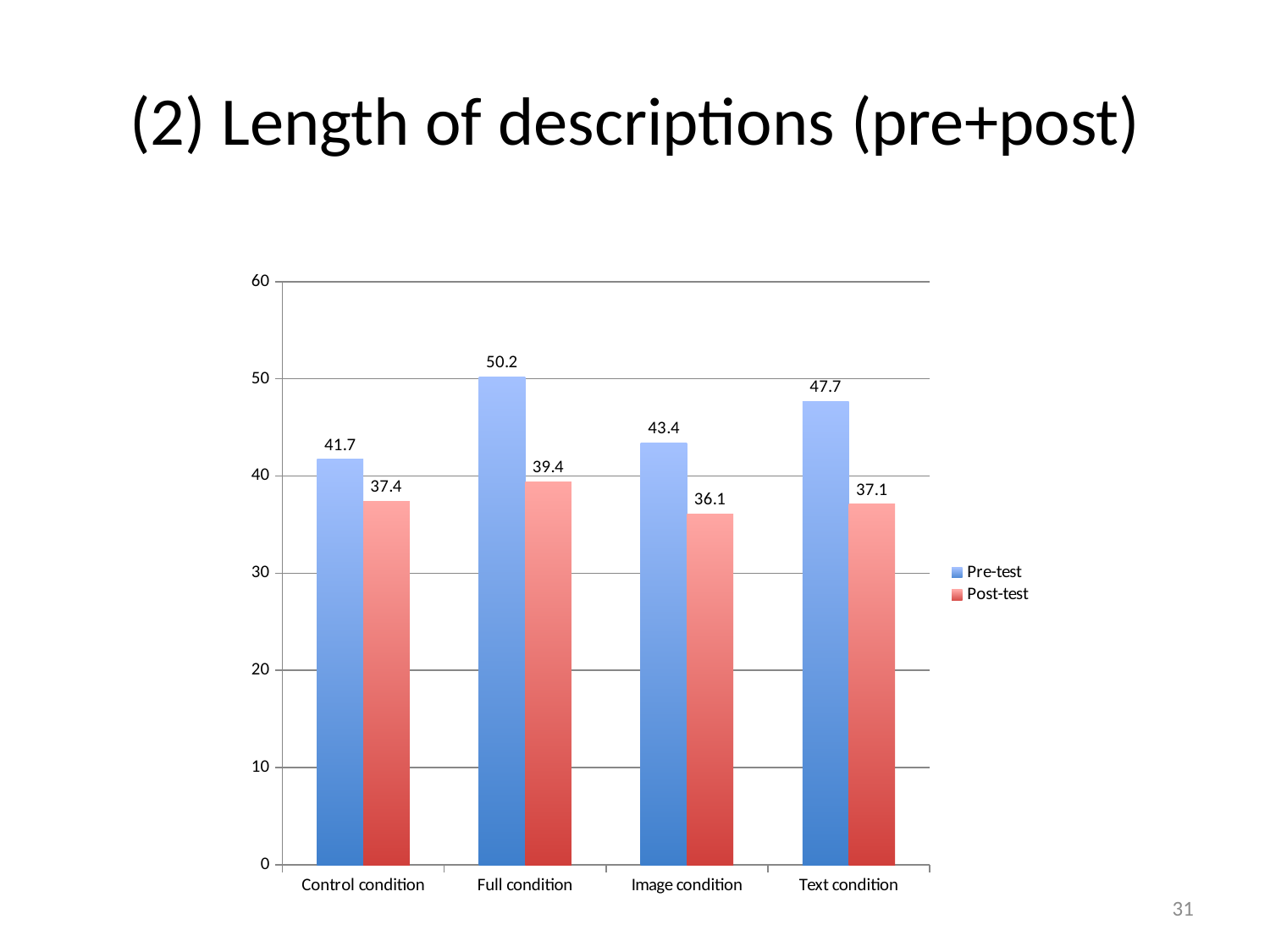
What colour are the Post-test bars? Red What kind of chart is shown on the slide? Bar chart What is the difference between the Pre-test and Post-test values for the Text condition? 10.6 What is the Pre-test value for the Full condition? 50.2 Which condition has the lowest Post-test value? Image condition Is the Pre-test value for the Text condition greater or less than 40? greater Which is larger, the Pre-test value for the Control condition or the Pre-test value for the Image condition? Image condition Which condition has the highest Pre-test value? Full condition How many series does the legend list? 2 What is the Post-test value for the Image condition? 36.1 How many conditions are shown on the x axis? 4 What is the Post-test value for the Control condition? 37.4